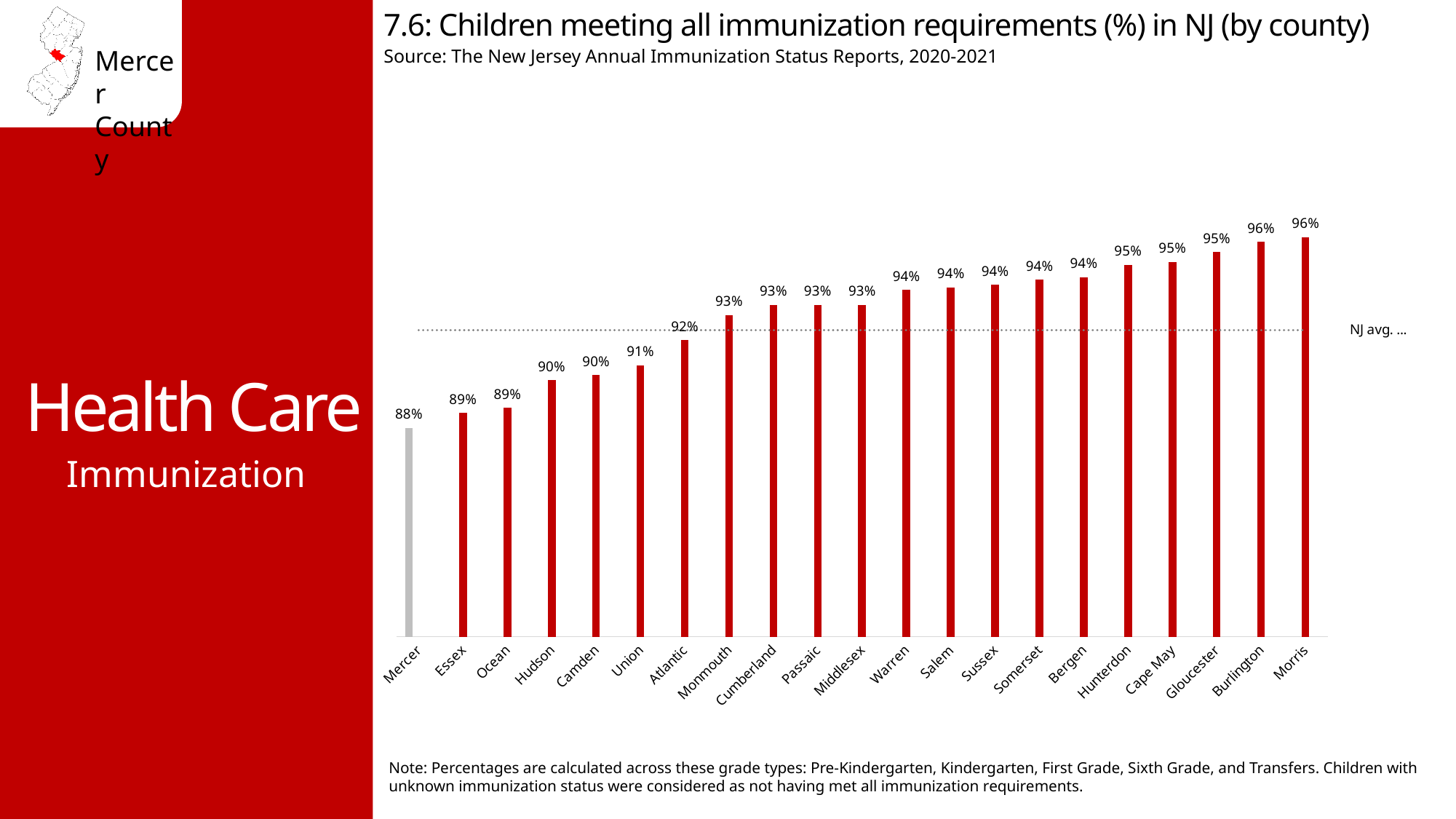
What is the difference in percentage points between Morris County and Mercer County? 8 percentage points Which has a higher value, Union County or Atlantic County? Atlantic What kind of chart is shown on the slide? Bar chart What percentage of children in Mercer County met all immunization requirements? 88% How many counties are shown on the chart? 21 Which county has the lowest percentage of children meeting all immunization requirements? Mercer Do the values rise or fall moving from left to right along the x axis? Rise What is the value shown for Atlantic County? 92% Which county's bar is coloured grey instead of red? Mercer What is the value shown for Hunterdon County? 95% What is the difference in percentage points between Hudson County and Mercer County? 2 percentage points What is the value shown for Passaic County? 93%